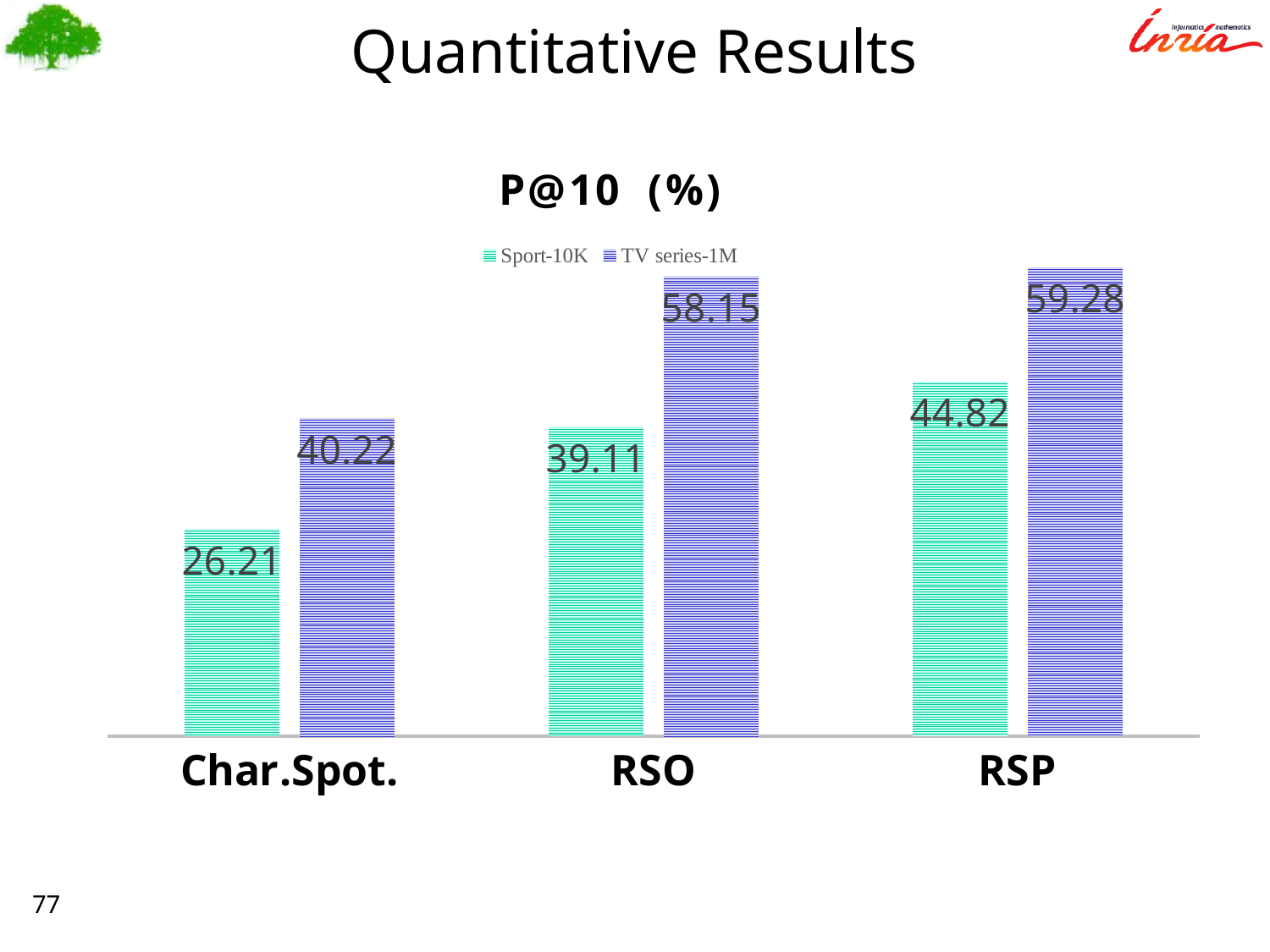
What is the P@10 value for Sport-10K on RSO? 39.11 Do the TV series-1M values rise or fall from Char.Spot. to RSP? Rise What is the title of the chart? P@10 (%) Which method has the highest P@10 for Sport-10K? RSP What is the P@10 value for Sport-10K on Char.Spot.? 26.21 What kind of chart is shown on the slide? Bar chart Which is larger: the Sport-10K value for RSP or the TV series-1M value for Char.Spot.? Sport-10K value for RSP How many series does the legend list? 2 Which method has the lowest P@10 for TV series-1M? Char.Spot. What is the difference between the TV series-1M and Sport-10K values for RSO? 19.04 How many methods are shown on the x axis? 3 What is the P@10 value for TV series-1M on RSP? 59.28